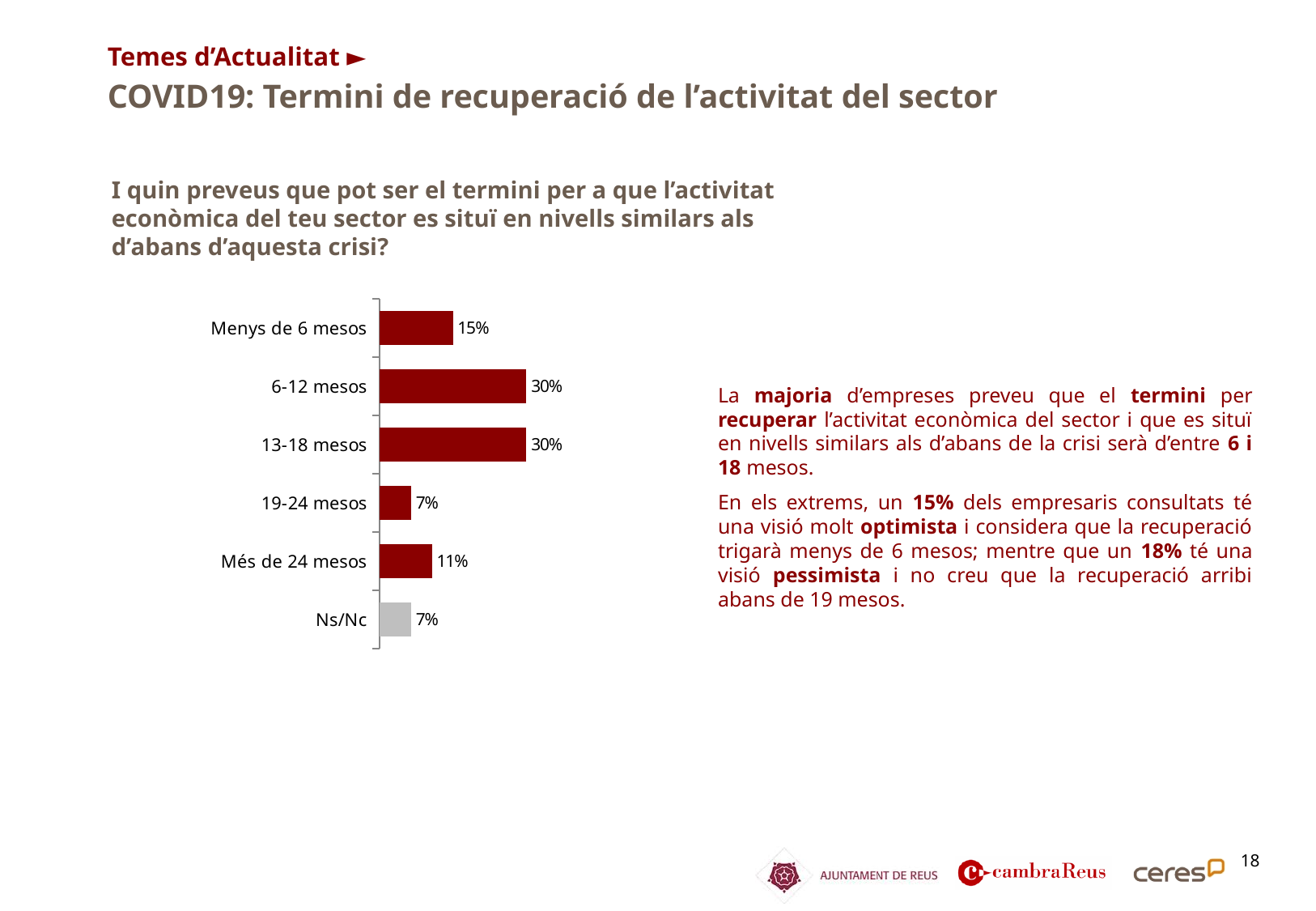
How many categories are plotted in the chart? 6 What kind of chart is shown on the slide? Bar chart What is the difference between the value for Més de 24 mesos and the value for 19-24 mesos? 4 percentage points What is the value shown for the 6-12 mesos category? 30% What is the value for the Ns/Nc category? 7% Which is larger, the value for Menys de 6 mesos or the value for Més de 24 mesos? Menys de 6 mesos What is the difference between the value for 6-12 mesos and the value for Menys de 6 mesos? 15 percentage points What percentage is shown for Més de 24 mesos? 11% What is the value shown for the 13-18 mesos category? 30% What percentage of companies expect recovery in less than 6 months (Menys de 6 mesos)? 15% What percentage is shown for 19-24 mesos? 7% Which bar in the chart is coloured grey instead of dark red? Ns/Nc